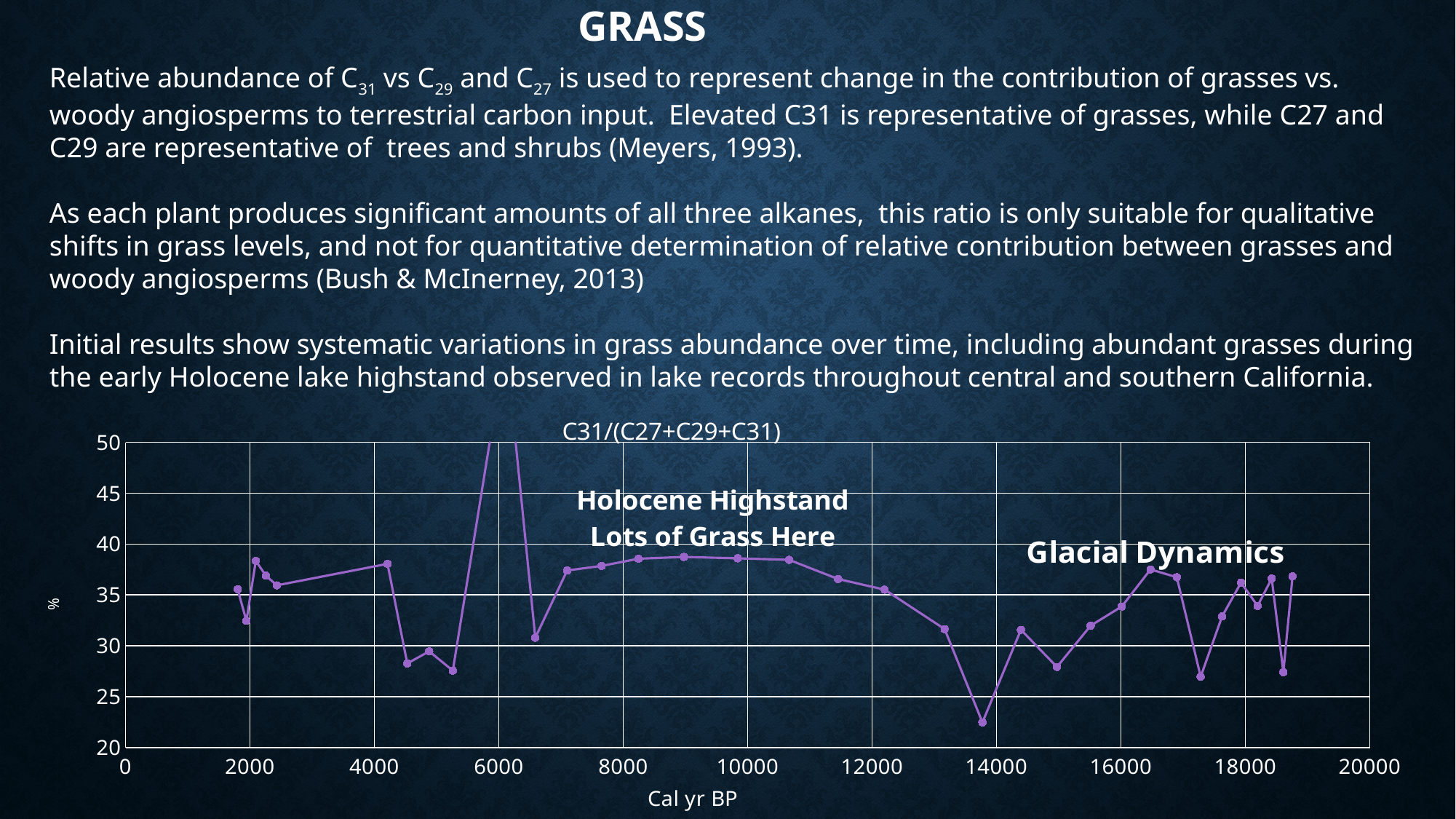
Which is larger, the value at about 9000 Cal yr BP or the value at about 13800 Cal yr BP? about 9000 Cal yr BP Does the line rise or fall between about 10700 and 13800 Cal yr BP? fall Is the value at about 9000 Cal yr BP greater or less than 35? greater Is the value at about 13800 Cal yr BP greater or less than 25? less Is the value at about 17300 Cal yr BP greater or less than 30? less What is the label of the x axis of the chart? Cal yr BP What kind of chart is shown on the slide? line chart What is the title of the chart? C31/(C27+C29+C31) How many data series are plotted in the chart? 1 Between which two x-axis tick values does the lowest point of the line fall? 12000 and 14000